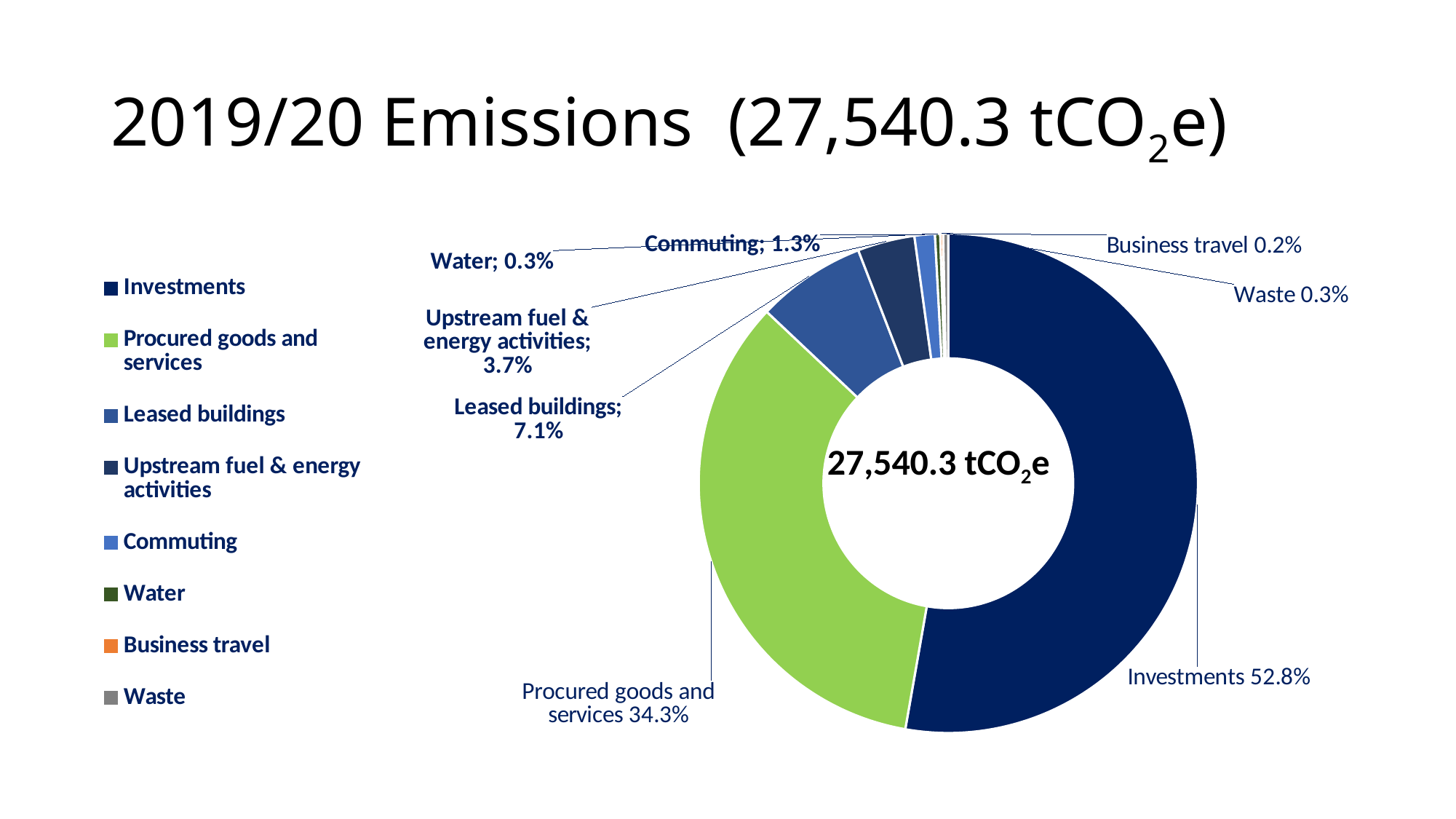
What share of emissions comes from Procured goods and services? 34.3% Which category has the largest share of emissions? Investments What share of emissions comes from Upstream fuel & energy activities? 3.7% What total emissions figure is shown in the centre of the chart? 27,540.3 tCO2e What is the difference in percentage points between Investments and Procured goods and services? 18.5 Which category has the smallest share of emissions? Business travel What share of emissions comes from Business travel? 0.2% What share of emissions comes from Investments? 52.8% What share of emissions comes from Commuting? 1.3% Which has a larger share, Leased buildings or Upstream fuel & energy activities? Leased buildings How many categories does the legend list? 8 What share of emissions comes from Leased buildings? 7.1%